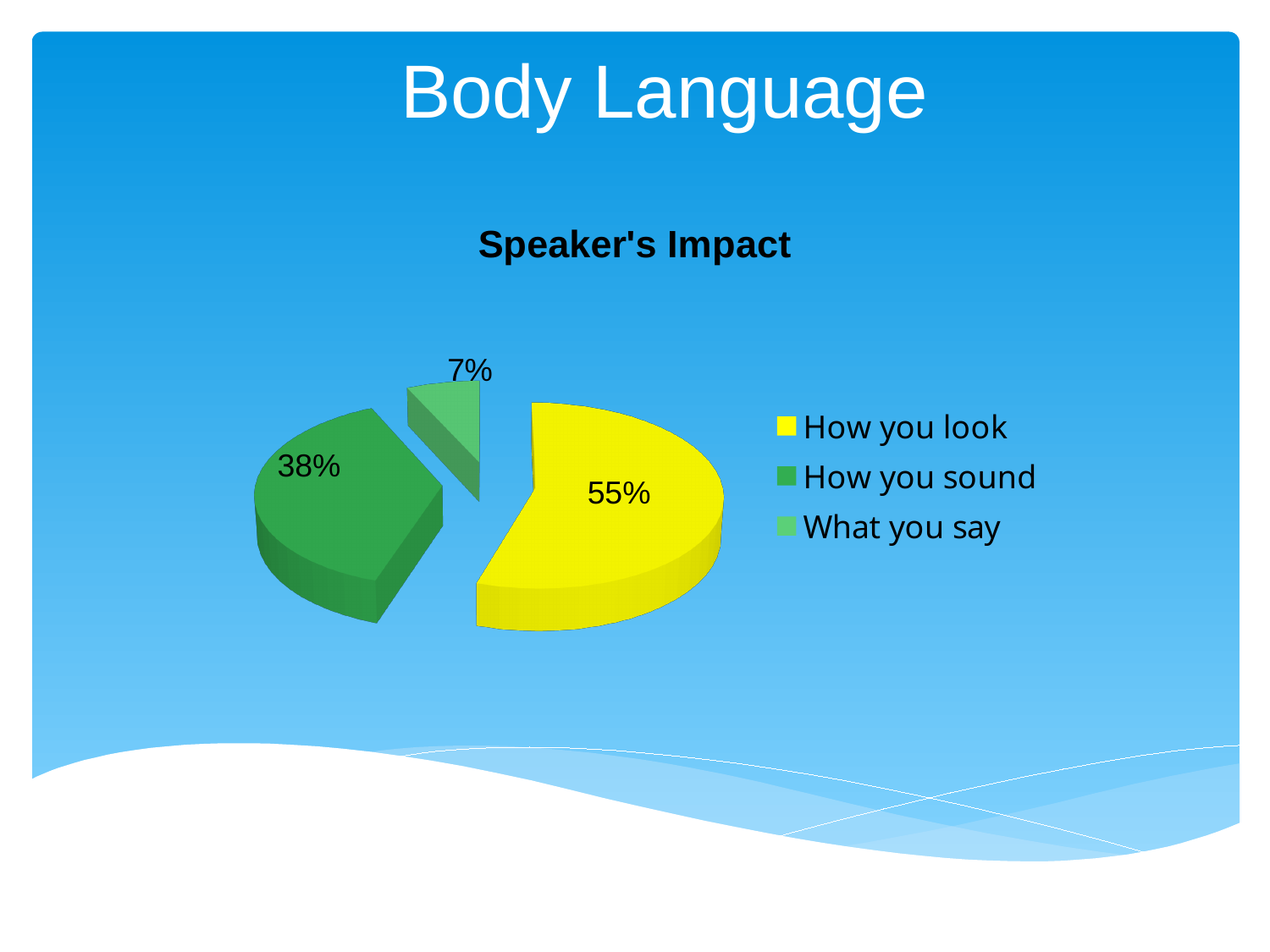
Which is larger, the share for "How you sound" or the share for "What you say"? How you sound Which category has the smallest share of the pie? What you say What kind of chart is shown on the slide? Pie chart What percentage is shown for "How you look"? 55% What is the difference between the shares for "How you look" and "How you sound"? 17% Which category has the largest share of the pie? How you look What is the difference between the shares for "How you sound" and "What you say"? 31% What percentage is shown for "How you sound"? 38% Which colour represents "How you look" in the legend? Yellow What is the title of the chart? Speaker's Impact How many slices does the pie chart have? 3 What percentage is shown for "What you say"? 7%